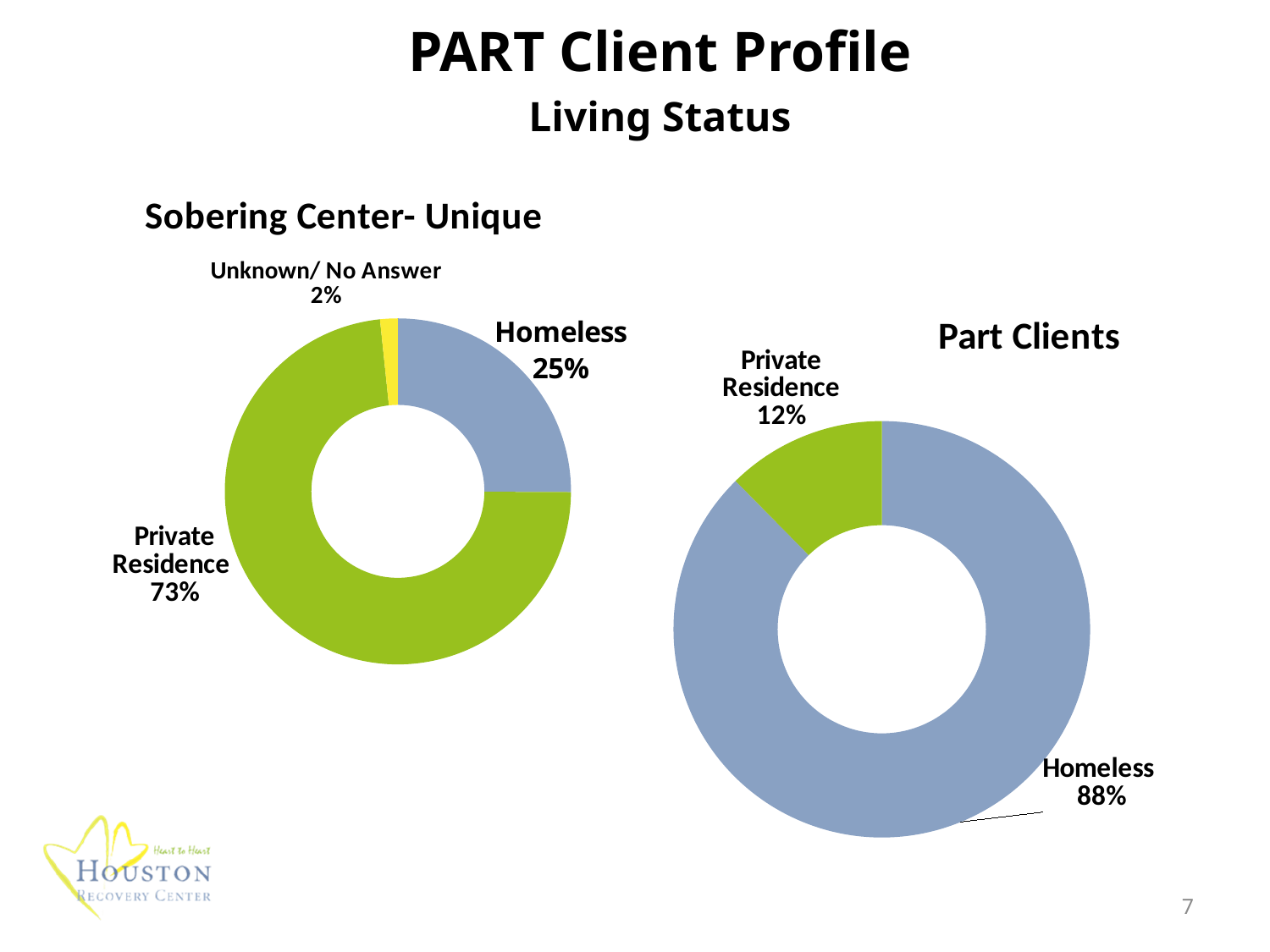
In the 'Sobering Center- Unique' chart, what percentage is Private Residence? 73% In the 'Sobering Center- Unique' chart, what percentage is Homeless? 25% In the 'Part Clients' chart, which category has the largest share? Homeless In the 'Part Clients' chart, what is the difference between the Homeless and Private Residence percentages? 76% In the 'Part Clients' chart, what percentage is Homeless? 88% In the 'Sobering Center- Unique' chart, which category has the largest share? Private Residence In the 'Part Clients' chart, how many categories are shown? 2 In the 'Sobering Center- Unique' chart, how many categories are shown? 3 In the 'Sobering Center- Unique' chart, which category has the smallest share? Unknown/ No Answer In the 'Part Clients' chart, what percentage is Private Residence? 12% What type of chart is the 'Part Clients' chart? Doughnut chart In the 'Sobering Center- Unique' chart, what percentage is Unknown/ No Answer? 2%